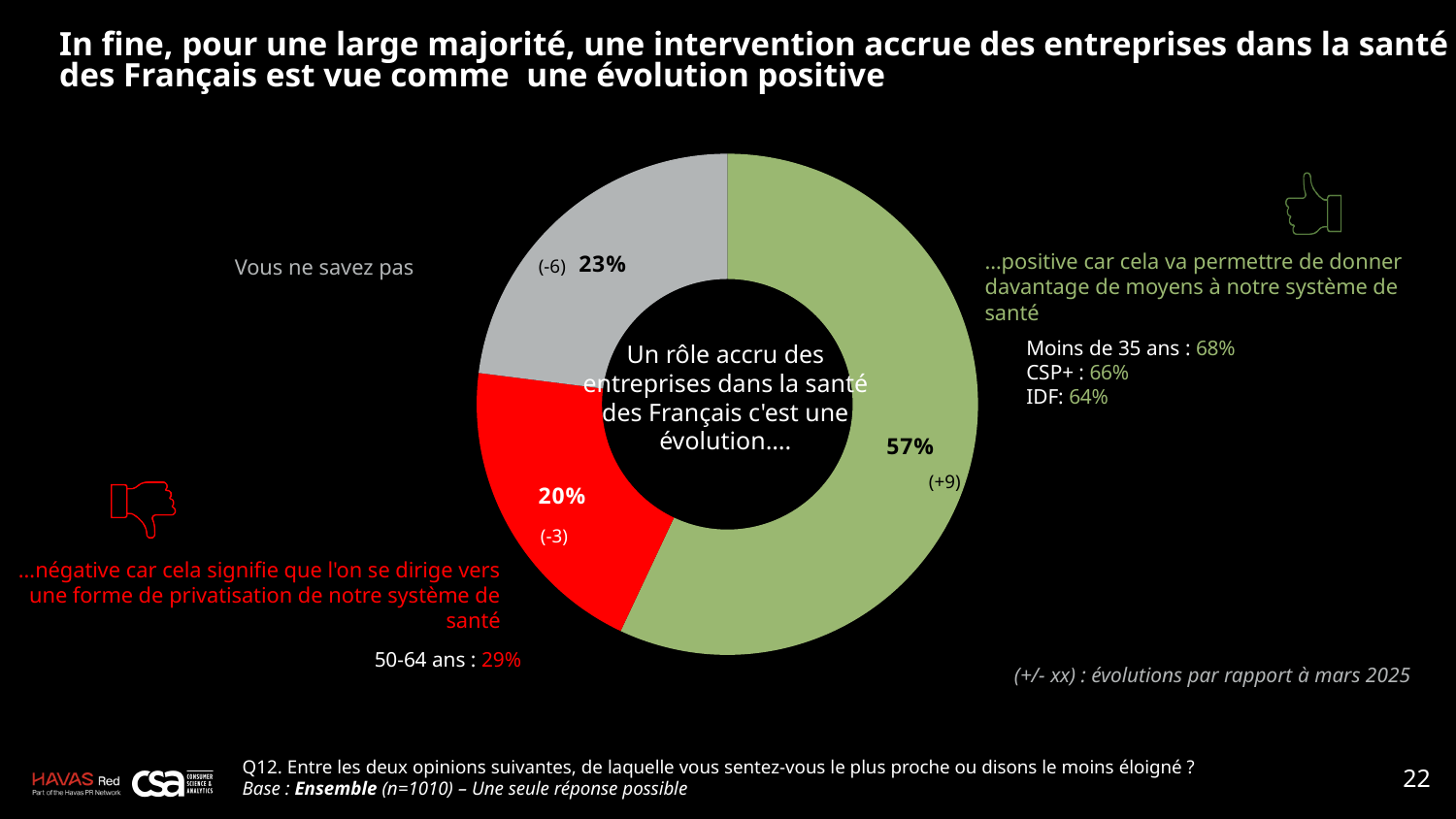
What colour is the slice representing the negative response? Red What is the change since March 2025 for the "Vous ne savez pas" response? -6 What share of respondents see it as a negative evolution (privatisation of the health system)? 20% Which response has the largest share of the donut chart? positive (57%) What is the difference in percentage points between the positive and negative responses? 37 points Which is larger: the share of "Vous ne savez pas" or the share of negative responses? Vous ne savez pas (23%) How many slices does the donut chart have? 3 Which response has the smallest share of the donut chart? négative (20%) What is the change since March 2025 for the positive response? +9 What share of respondents see an increased role of companies in health as a positive evolution? 57% What type of chart is shown on the slide? Donut (pie) chart What share of respondents answered "Vous ne savez pas"? 23%